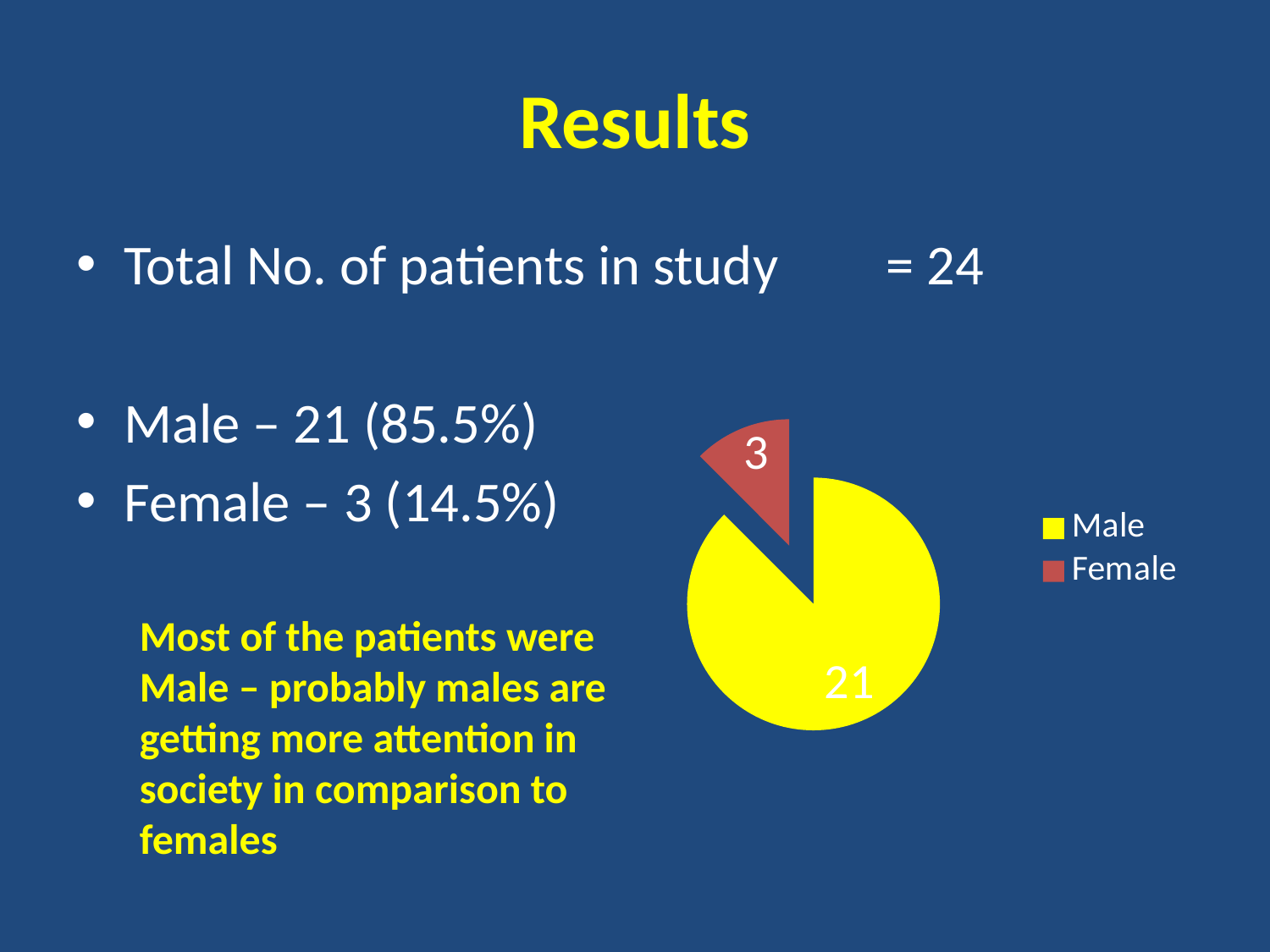
Which category has the largest slice in the pie chart? Male What is the value for Female in the pie chart? 3 What colour is the Male slice in the pie chart? yellow What is the total of the values shown in the pie chart? 24 What is the difference between the Male and Female values in the pie chart? 18 How many entries does the pie chart legend list? 2 Which category has the smallest slice in the pie chart? Female Which slice is pulled out from the pie chart? Female What is the value for Male in the pie chart? 21 Which is larger in the pie chart, Male or Female? Male How many slices does the pie chart have? 2 What type of chart is shown on the slide? pie chart